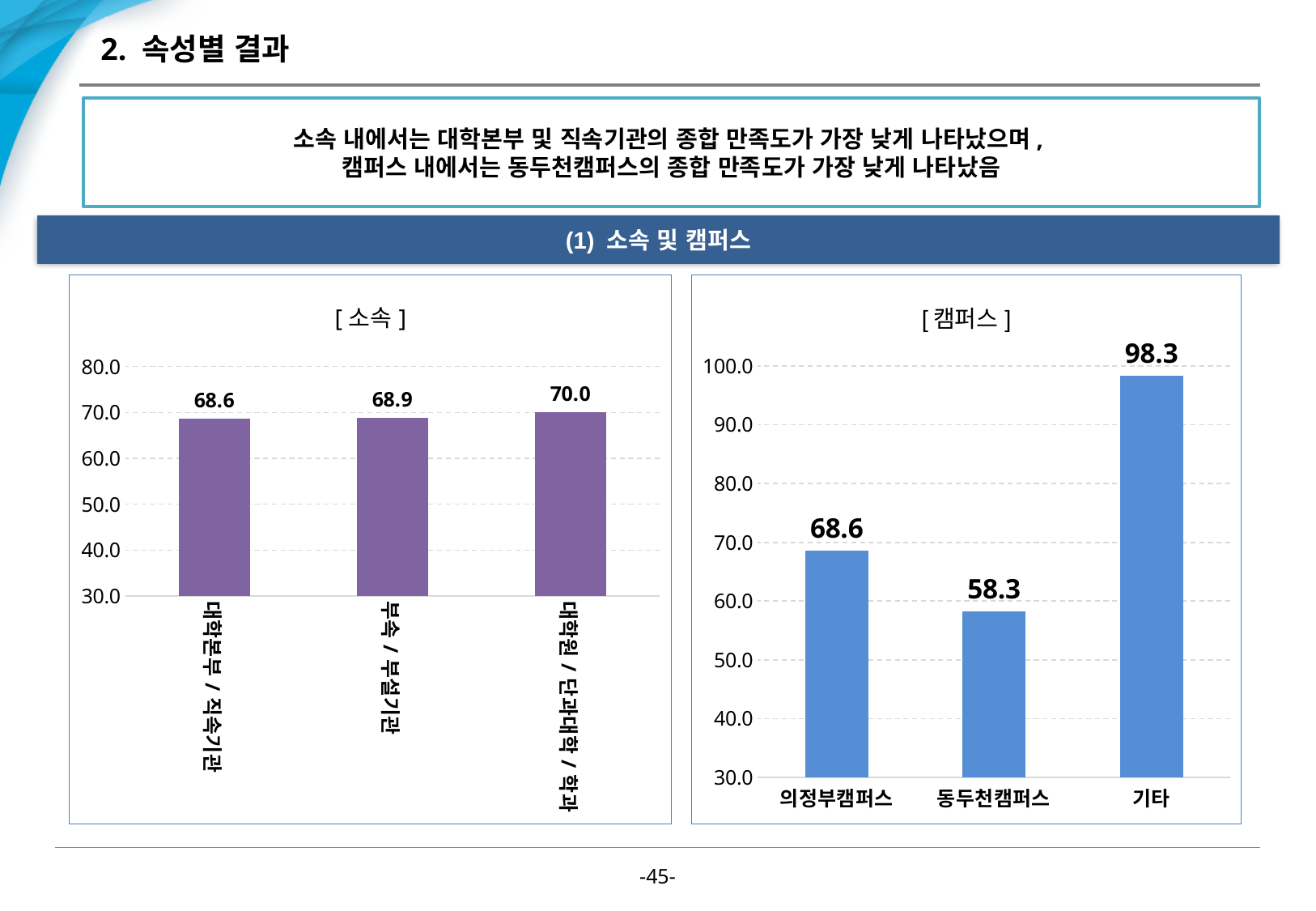
In the [캠퍼스] chart, what is the difference between 의정부캠퍼스 and 동두천캠퍼스? 10.3 In the [소속] chart, what is the value for 대학원 / 단과대학 / 학과? 70.0 In the [캠퍼스] chart, which category has the lowest value? 동두천캠퍼스 In the [캠퍼스] chart, which category has the highest value? 기타 What kind of chart is the [캠퍼스] chart? bar chart In the [캠퍼스] chart, what is the value for 기타? 98.3 In the [소속] chart, what is the value for 대학본부 / 직속기관? 68.6 In the [소속] chart, how many categories are shown? 3 In the [캠퍼스] chart, is the value for 동두천캠퍼스 greater or less than 60.0? less In the [캠퍼스] chart, what is the value for 동두천캠퍼스? 58.3 In the [소속] chart, which category has the lowest value? 대학본부 / 직속기관 In the [소속] chart, what is the difference between 대학원 / 단과대학 / 학과 and 대학본부 / 직속기관? 1.4